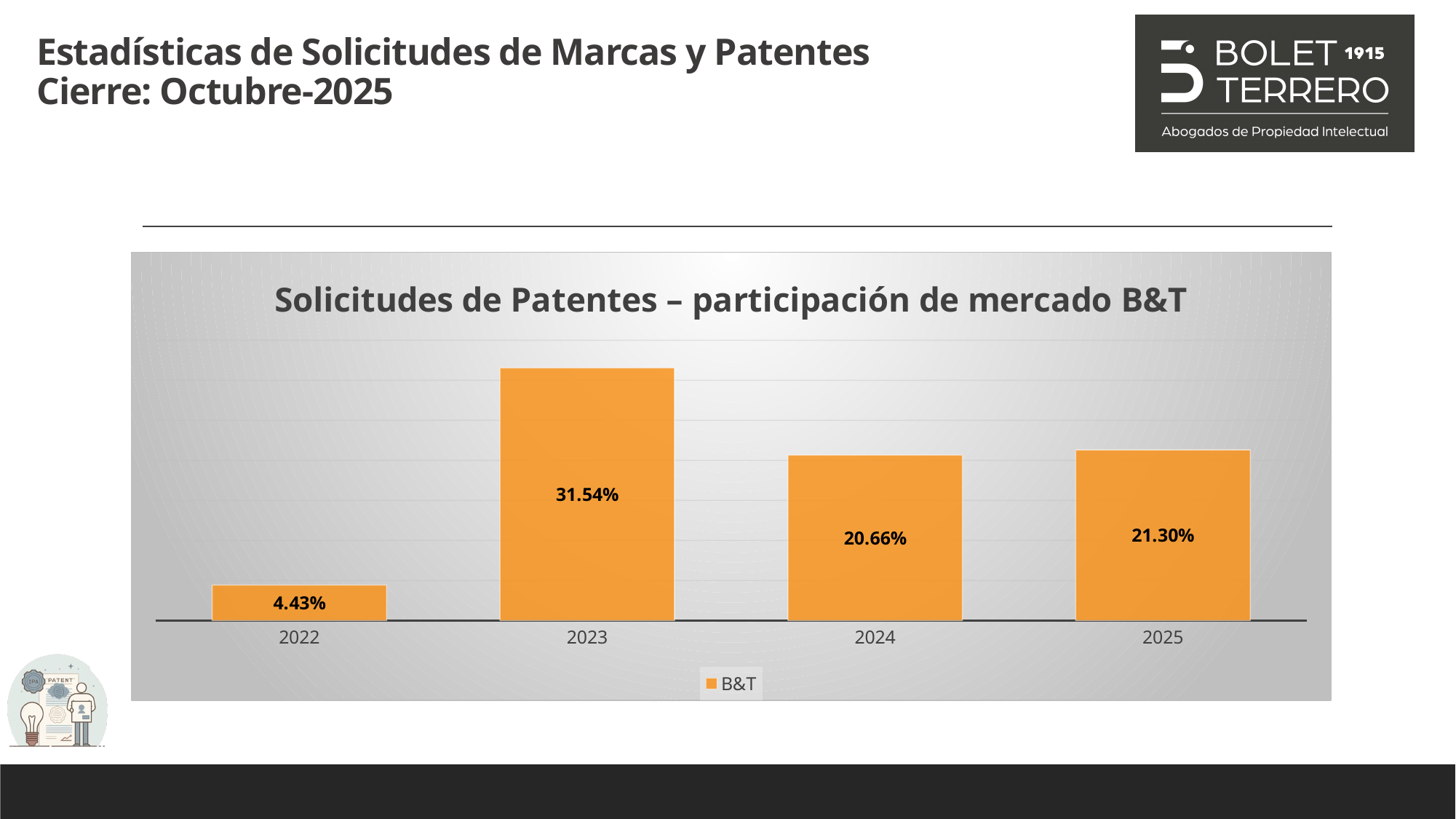
How many years are shown on the x axis? 4 Which year has the lowest B&T market share? 2022 What is the B&T market share for 2025? 21.30% What kind of chart is shown? Bar chart What is the difference in B&T market share between 2023 and 2024? 10.88% What is the name of the series in the legend? B&T What is the B&T market share for 2023? 31.54% What is the B&T market share for 2022? 4.43% How many series does the legend list? 1 What is the title of the chart? Solicitudes de Patentes – participación de mercado B&T Which year has the highest B&T market share? 2023 Which year has a larger B&T market share, 2024 or 2025? 2025